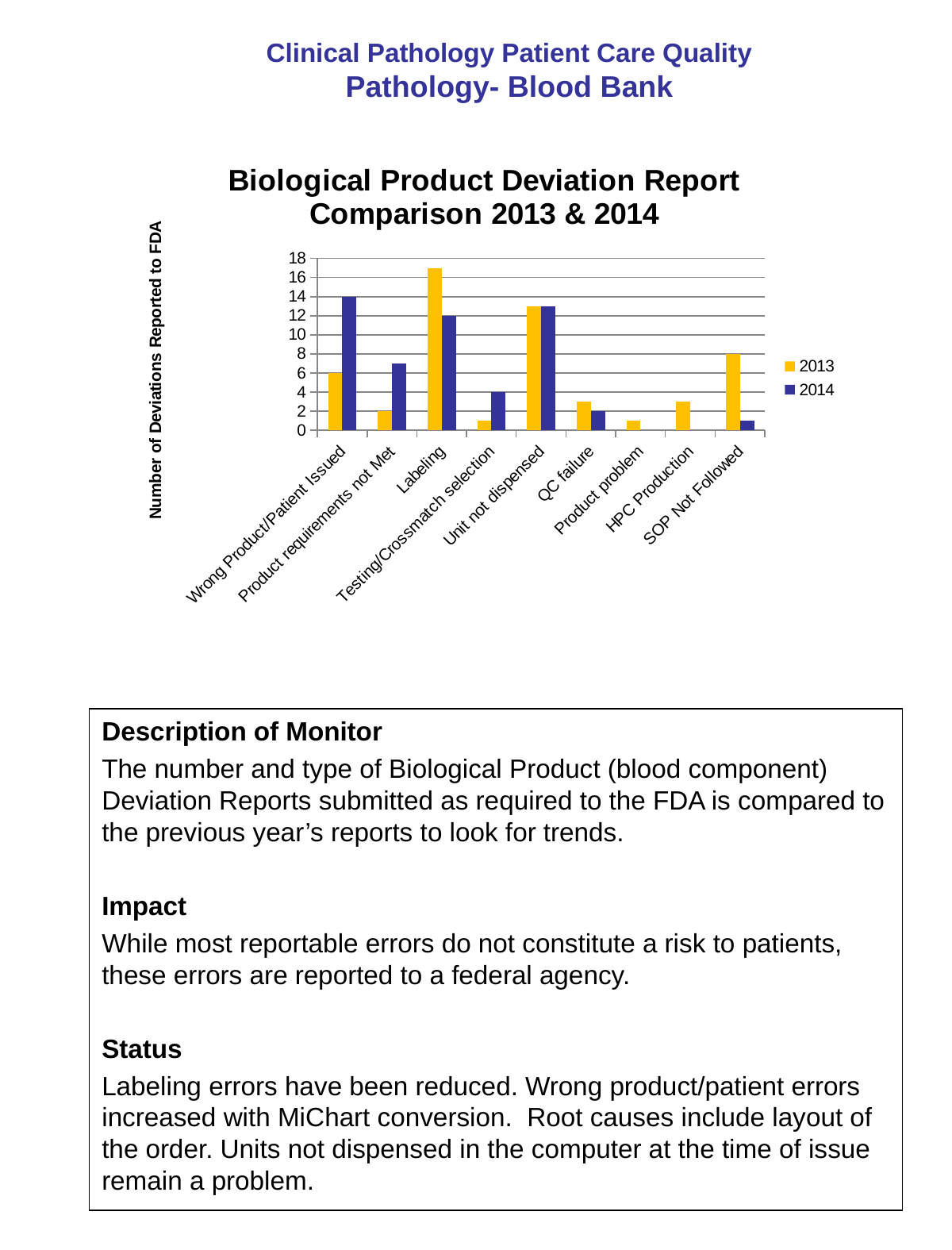
What is the 2013 value for Wrong Product/Patient Issued? 6 Is the 2013 value for Labeling greater or less than 16? greater Which category has the highest bar in the chart? Labeling What kind of chart is shown on the slide? bar chart For Wrong Product/Patient Issued, which year has the larger value, 2013 or 2014? 2014 What is the difference between the 2014 and 2013 values for Wrong Product/Patient Issued? 8 What is the 2014 value for Labeling? 12 What is the title of the chart? Biological Product Deviation Report Comparison 2013 & 2014 How many series does the legend list? 2 What is the 2013 value for SOP Not Followed? 8 What is the 2014 value for Wrong Product/Patient Issued? 14 How many categories are shown on the x axis? 9